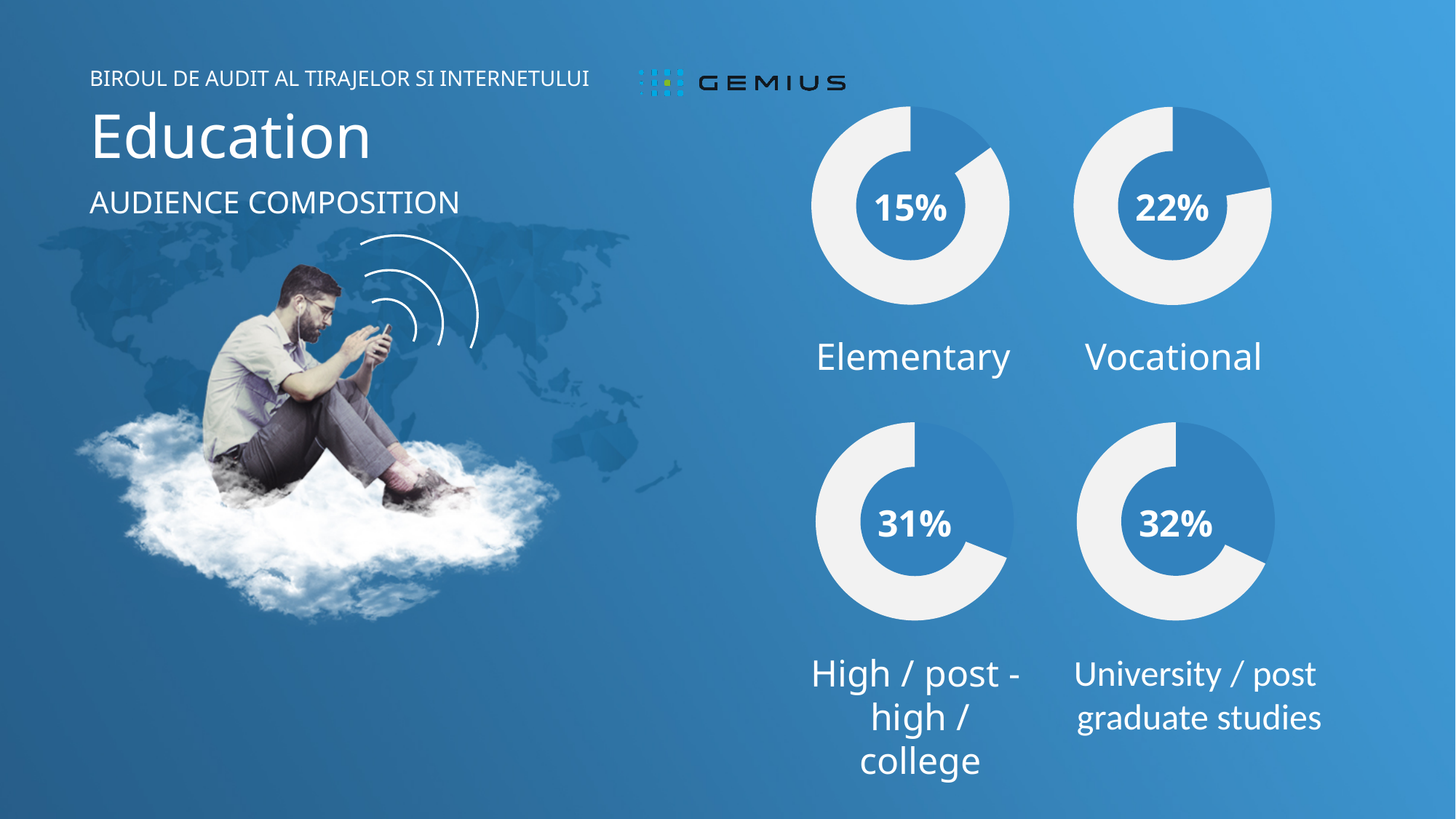
What is the combined share of the Elementary and Vocational categories? 37% What percentage is shown in the University / post graduate studies donut chart? 32% What is the difference between the University / post graduate studies share and the High / post-high / college share? 1% What percentage is shown in the Vocational donut chart? 22% Which education category has the lowest share of the audience? Elementary How many donut charts are shown on the slide? 4 What kind of chart is used to show each education category? Donut chart What percentage is shown in the High / post-high / college donut chart? 31% Which is larger, the Vocational share or the Elementary share? Vocational Which education category has the highest share of the audience? University / post graduate studies What is the difference between the Vocational share and the Elementary share? 7% What percentage is shown in the Elementary donut chart? 15%